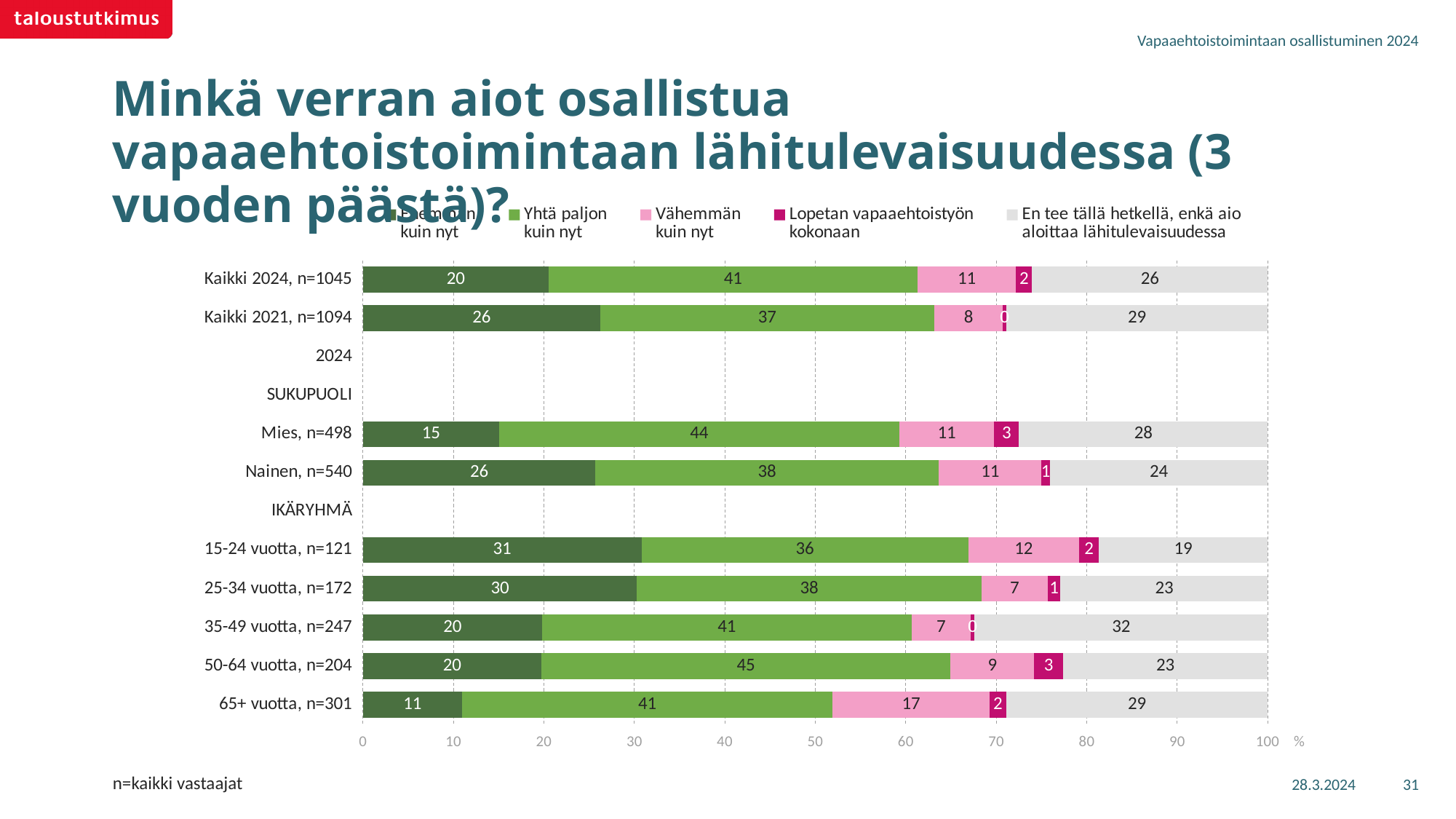
Which group has the highest value for "Yhtä paljon kuin nyt"? 50-64 vuotta, n=204 What is the value of "Yhtä paljon kuin nyt" for Kaikki 2024, n=1045? 41 What is the value of "Lopetan vapaaehtoistyön kokonaan" for Mies, n=498? 3 How many series does the legend list? 5 What is the value of "Vähemmän kuin nyt" for 65+ vuotta, n=301? 17 What is the difference between the "Vähemmän kuin nyt" values for 65+ vuotta, n=301 and 25-34 vuotta, n=172? 10 What is the value of "En tee tällä hetkellä, enkä aio aloittaa lähitulevaisuudessa" for 35-49 vuotta, n=247? 32 Which has a larger "Yhtä paljon kuin nyt" value, Mies, n=498 or Nainen, n=540? Mies, n=498 What is the total of the stacked bar for Kaikki 2021, n=1094? 100 What kind of chart is shown on the slide? Stacked bar chart What is the value of "Vähemmän kuin nyt" for Kaikki 2021, n=1094? 8 Which group has the lowest value for "En tee tällä hetkellä, enkä aio aloittaa lähitulevaisuudessa"? 15-24 vuotta, n=121